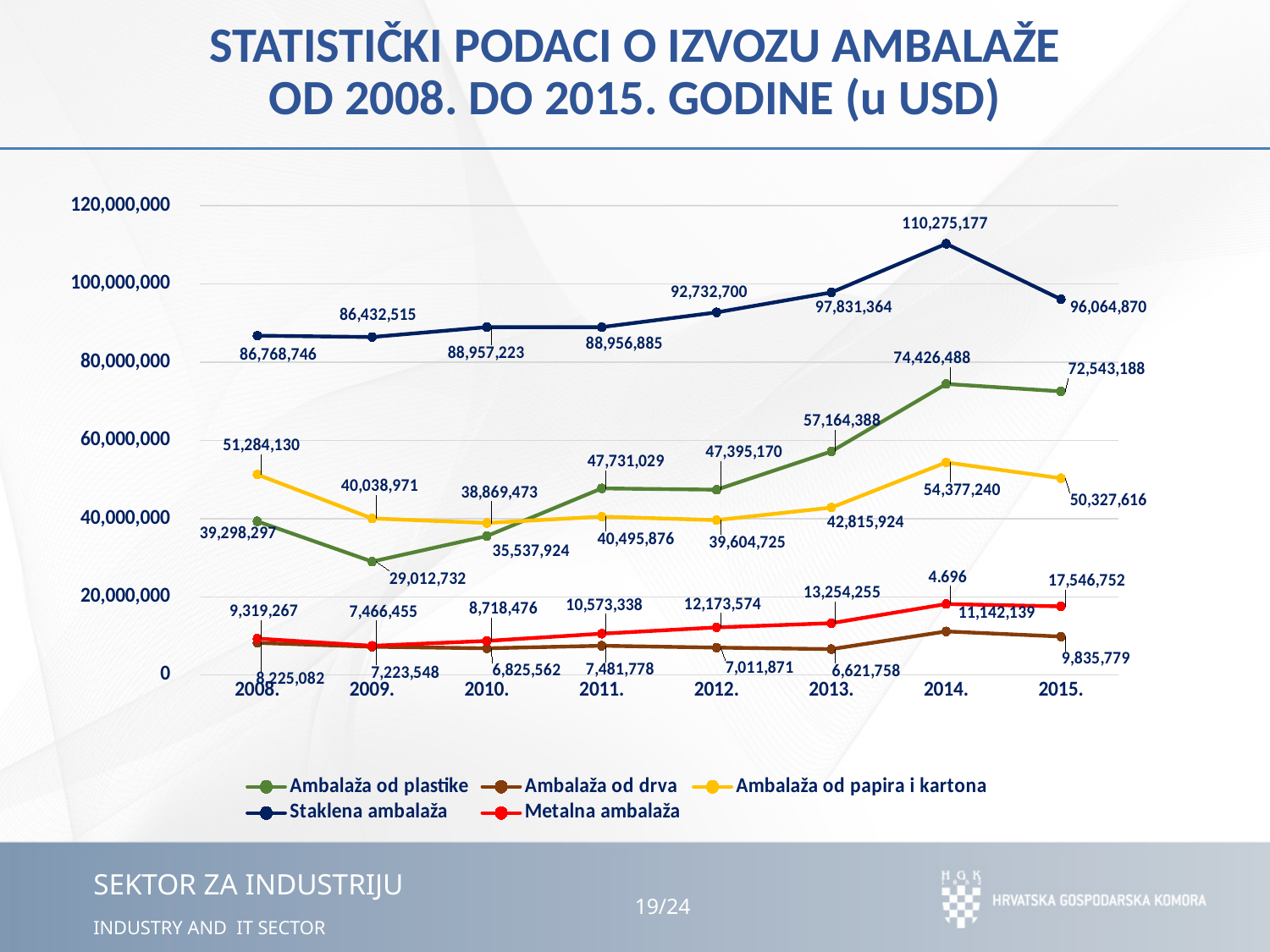
Is the value for Staklena ambalaža in 2008 greater or less than 80,000,000? greater What kind of chart is shown on the slide? line chart In which year does Staklena ambalaža reach its highest value? 2014. What is the value for Staklena ambalaža in 2014? 110,275,177 In 2008, which is larger: Ambalaža od papira i kartona or Ambalaža od plastike? Ambalaža od papira i kartona What is the value for Ambalaža od plastike in 2015? 72,543,188 How many series does the legend list? 5 Does the Ambalaža od plastike line rise or fall from 2012 to 2014? rise How many years are plotted along the x axis? 8 In which year is Ambalaža od plastike at its lowest value? 2009. What is the difference between the Staklena ambalaža values for 2014 and 2015? 14,210,307 Which series is drawn with the red line? Metalna ambalaža